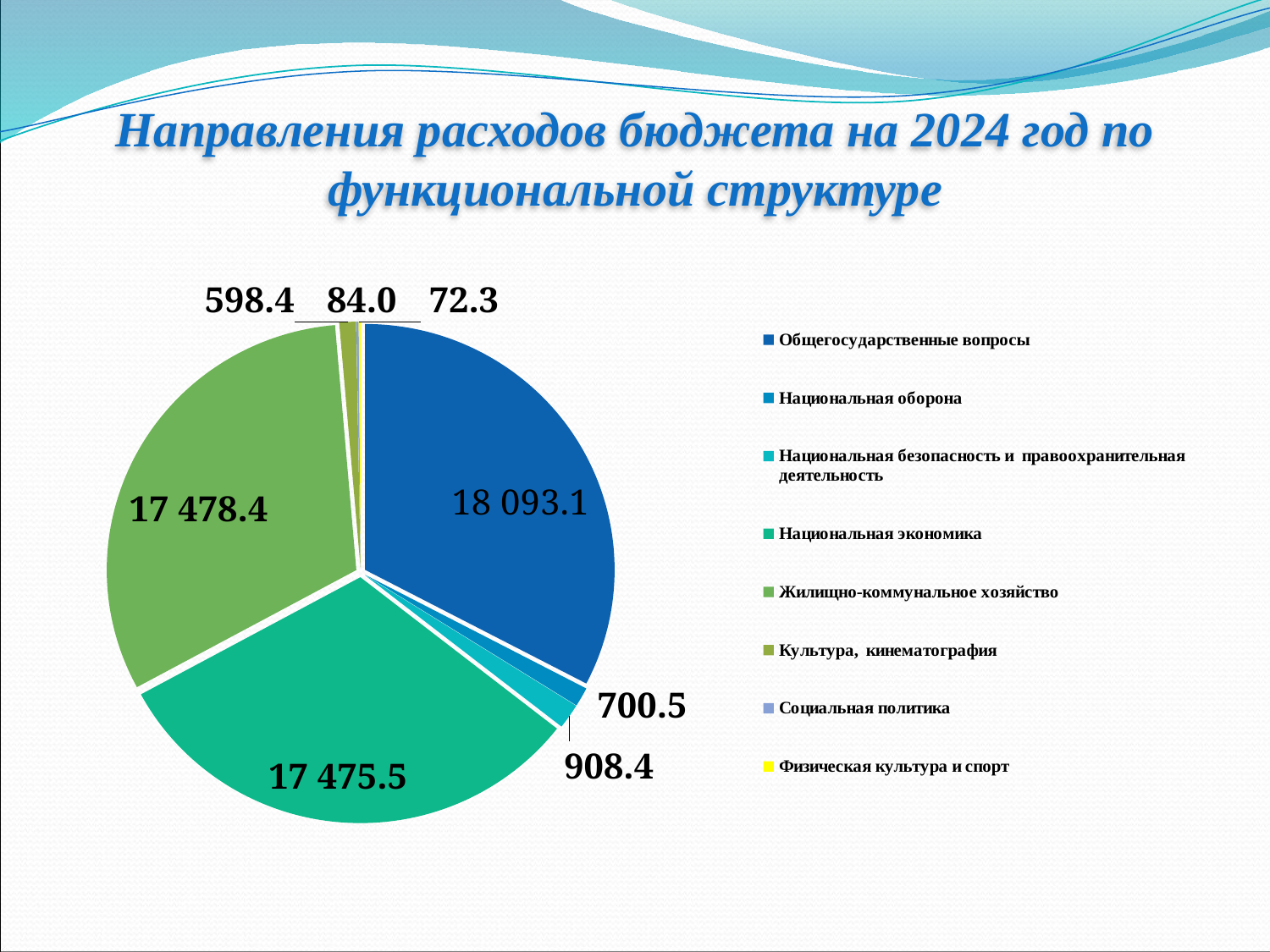
Which category has the largest slice of the pie? Общегосударственные вопросы What is the value for Национальная экономика? 17 475.5 What is the value for Общегосударственные вопросы? 18 093.1 What is the value for Национальная безопасность и правоохранительная деятельность? 908.4 What is the title of the slide? Направления расходов бюджета на 2024 год по функциональной структуре What type of chart is shown on the slide? Pie chart Which is larger: the value for Национальная безопасность и правоохранительная деятельность or the value for Национальная оборона? Национальная безопасность и правоохранительная деятельность How many categories does the pie chart have? 8 What is the value for Жилищно-коммунальное хозяйство? 17 478.4 Which category has the smallest slice of the pie? Физическая культура и спорт What is the value for Социальная политика? 84.0 What is the difference between the values for Общегосударственные вопросы and Жилищно-коммунальное хозяйство? 614.7